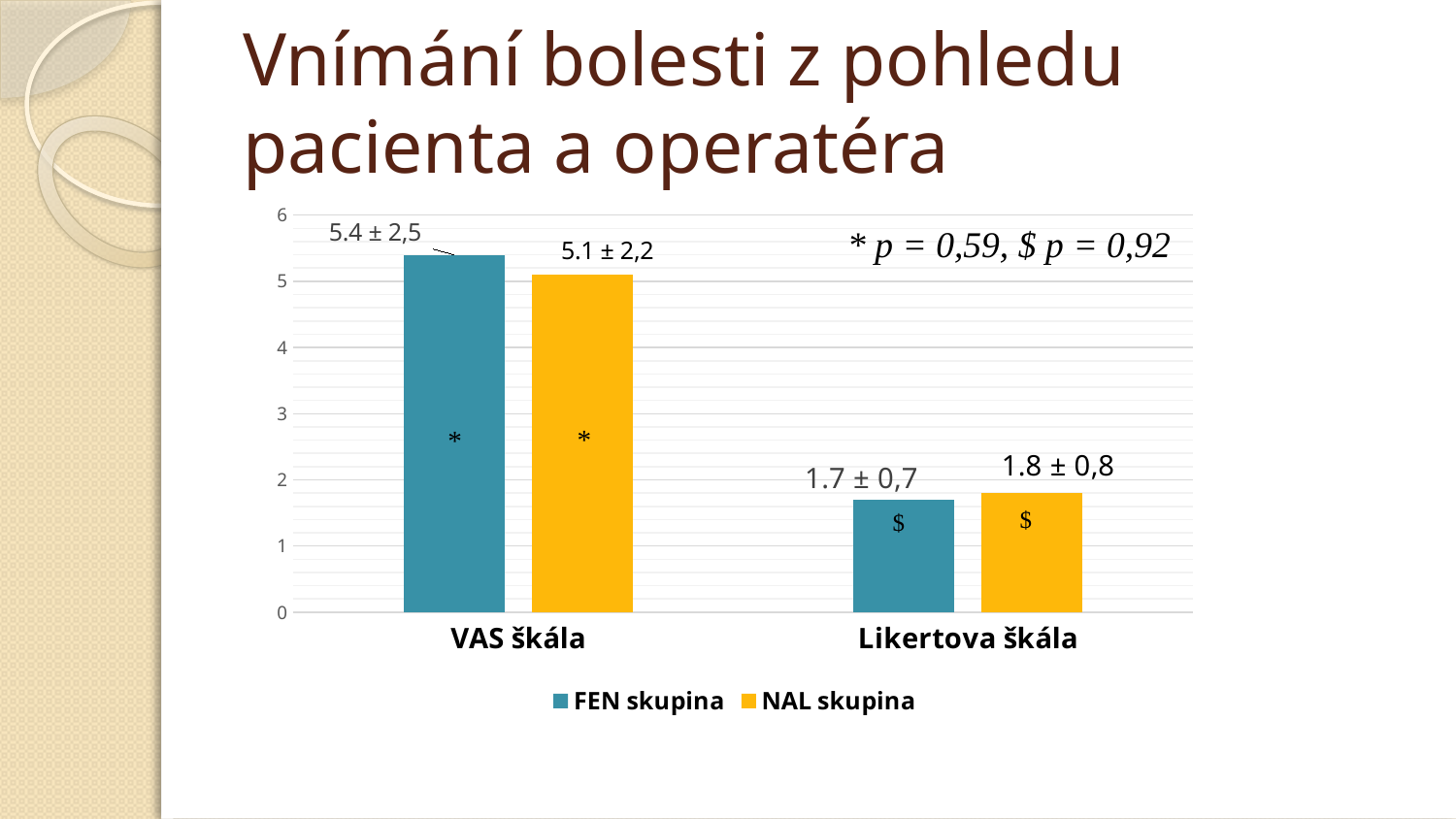
How many series does the legend list? 2 In the Likertova škála category, which group has the larger mean value, FEN skupina or NAL skupina? NAL skupina What is the value labelled for FEN skupina in the Likertova škála category? 1.7 ± 0,7 What is the difference between the mean values of FEN skupina and NAL skupina in the VAS škála category? 0.3 What is the value labelled for FEN skupina in the VAS škála category? 5.4 ± 2,5 How many categories are shown on the x axis? 2 What is the value labelled for NAL skupina in the VAS škála category? 5.1 ± 2,2 What is the value labelled for NAL skupina in the Likertova škála category? 1.8 ± 0,8 Which legend entry is shown in yellow? NAL skupina Which bar has the highest value on the chart? FEN skupina, VAS škála What kind of chart is shown on the slide? bar chart Which bar has the lowest value on the chart? FEN skupina, Likertova škála